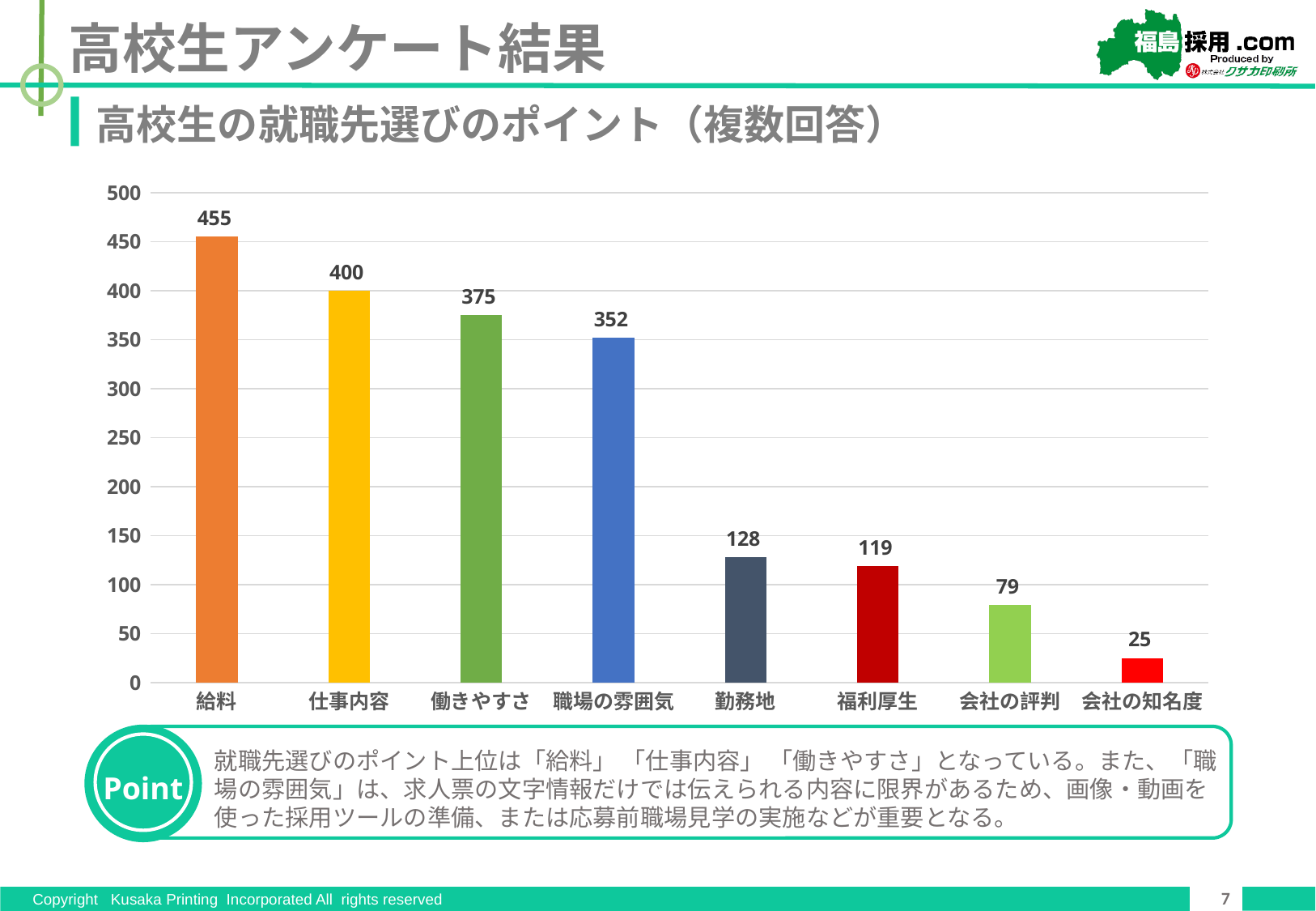
Which category has the lowest value? 会社の知名度 What is the title of the chart? 高校生の就職先選びのポイント（複数回答） Which category has the highest value? 給料 What is the value for 職場の雰囲気? 352 What is the value for 会社の評判? 79 How many categories are shown on the x axis? 8 Do the values rise or fall from left to right along the x axis? fall What is the difference between the values for 仕事内容 and 働きやすさ? 25 What is the difference between the values for 勤務地 and 福利厚生? 9 What kind of chart is shown on the slide? bar chart Which is larger, the value for 勤務地 or the value for 会社の評判? 勤務地 What is the value for 給料? 455